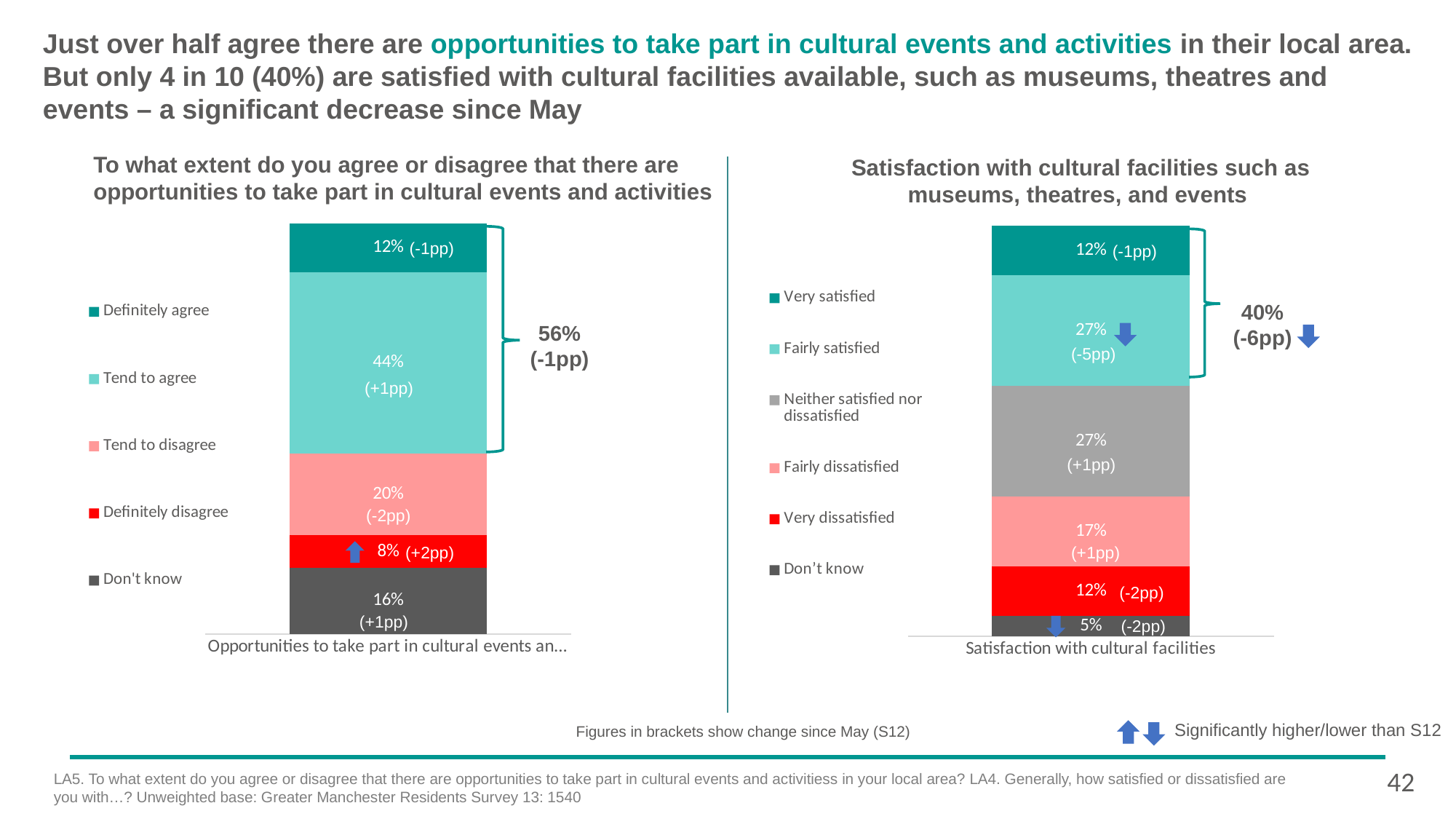
In the right chart on satisfaction with cultural facilities, which is larger: 'Very satisfied' or 'Fairly dissatisfied'? Fairly dissatisfied What type of chart is used on the right for satisfaction with cultural facilities? Stacked bar chart In the left chart on opportunities to take part in cultural events and activities, what percentage 'Tend to agree'? 44% In the right chart on satisfaction with cultural facilities, what is the combined share of 'Very satisfied' and 'Fairly satisfied'? 39% In the left chart on opportunities to take part in cultural events and activities, which response has the smallest share? Definitely disagree In the right chart on satisfaction with cultural facilities, what percentage are 'Fairly dissatisfied'? 17% In the left chart on opportunities to take part in cultural events and activities, which response has the largest share? Tend to agree In the right chart on satisfaction with cultural facilities, which response has the smallest share? Don't know In the left chart on opportunities to take part in cultural events and activities, how many response categories does the legend list? 5 In the left chart on opportunities to take part in cultural events and activities, what percentage 'Definitely disagree'? 8% In the right chart on satisfaction with cultural facilities, what percentage answered 'Don't know'? 5% In the left chart on opportunities to take part in cultural events and activities, what is the difference between 'Tend to agree' and 'Tend to disagree'? 24 percentage points